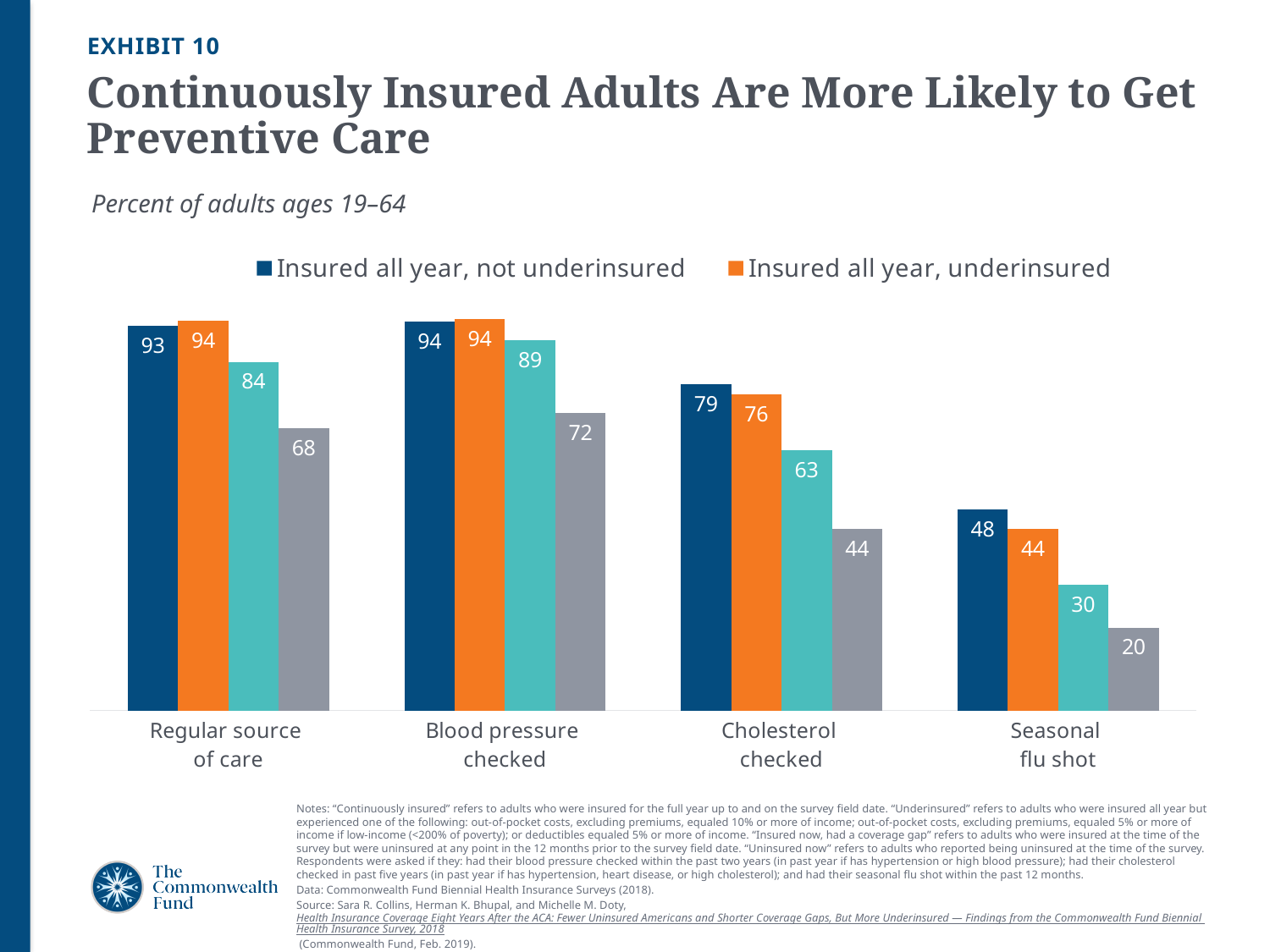
For Regular source of care, which is larger: "Insured all year, not underinsured" or "Insured all year, underinsured"? Insured all year, underinsured Which category has the lowest value for "Insured all year, underinsured"? Seasonal flu shot Which category has the highest value for "Insured all year, not underinsured"? Blood pressure checked What is the value for "Insured all year, underinsured" for Blood pressure checked? 94 For Seasonal flu shot, what is the difference between "Insured all year, not underinsured" and "Insured all year, underinsured"? 4 What is the value for "Insured all year, underinsured" for Seasonal flu shot? 44 What is the value for "Insured all year, not underinsured" for Regular source of care? 93 For Cholesterol checked, what is the difference between "Insured all year, not underinsured" and "Insured all year, underinsured"? 3 How many series does the legend list? 2 What kind of chart is shown on the slide? Bar chart What is the value for "Insured all year, not underinsured" for Cholesterol checked? 79 How many categories are shown on the x axis? 4